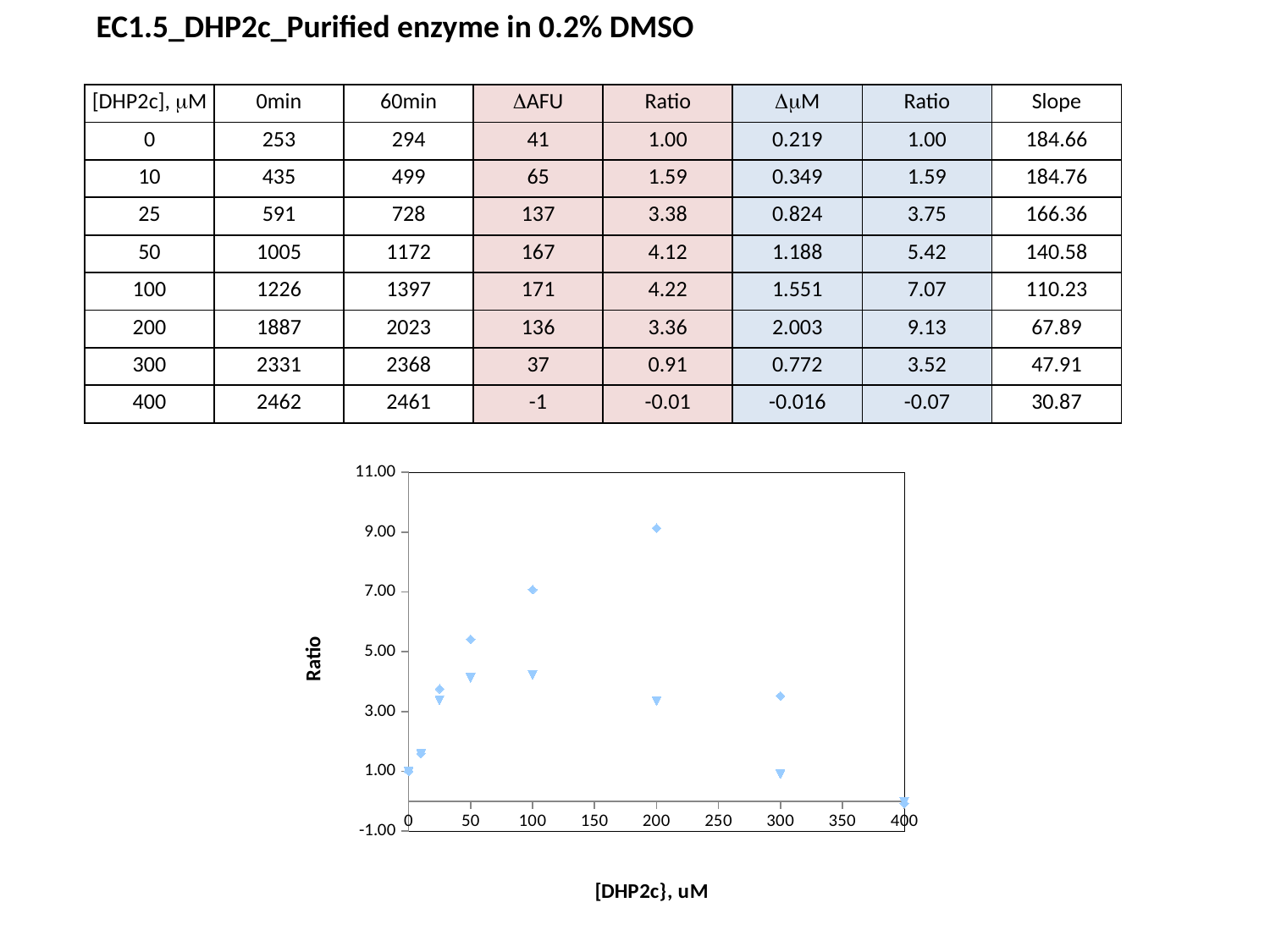
Is the highest point on the chart (at x = 200) greater or less than 7.00? greater What is the highest tick value shown on the y axis of the chart? 11.00 Does the diamond-marker series rise or fall between x = 0 and x = 200? rise Is the triangle-marker point at x = 300 greater or less than 3.00? less Is the diamond-marker point at x = 100 greater or less than 5.00? greater What is the title of the y axis of the chart? Ratio At which x-axis value does the highest point on the chart occur? 200 What kind of chart is shown on the slide? scatter chart What is the title of the x axis of the chart? [DHP2c}, uM How many distinct x-axis positions have plotted points on the chart? 8